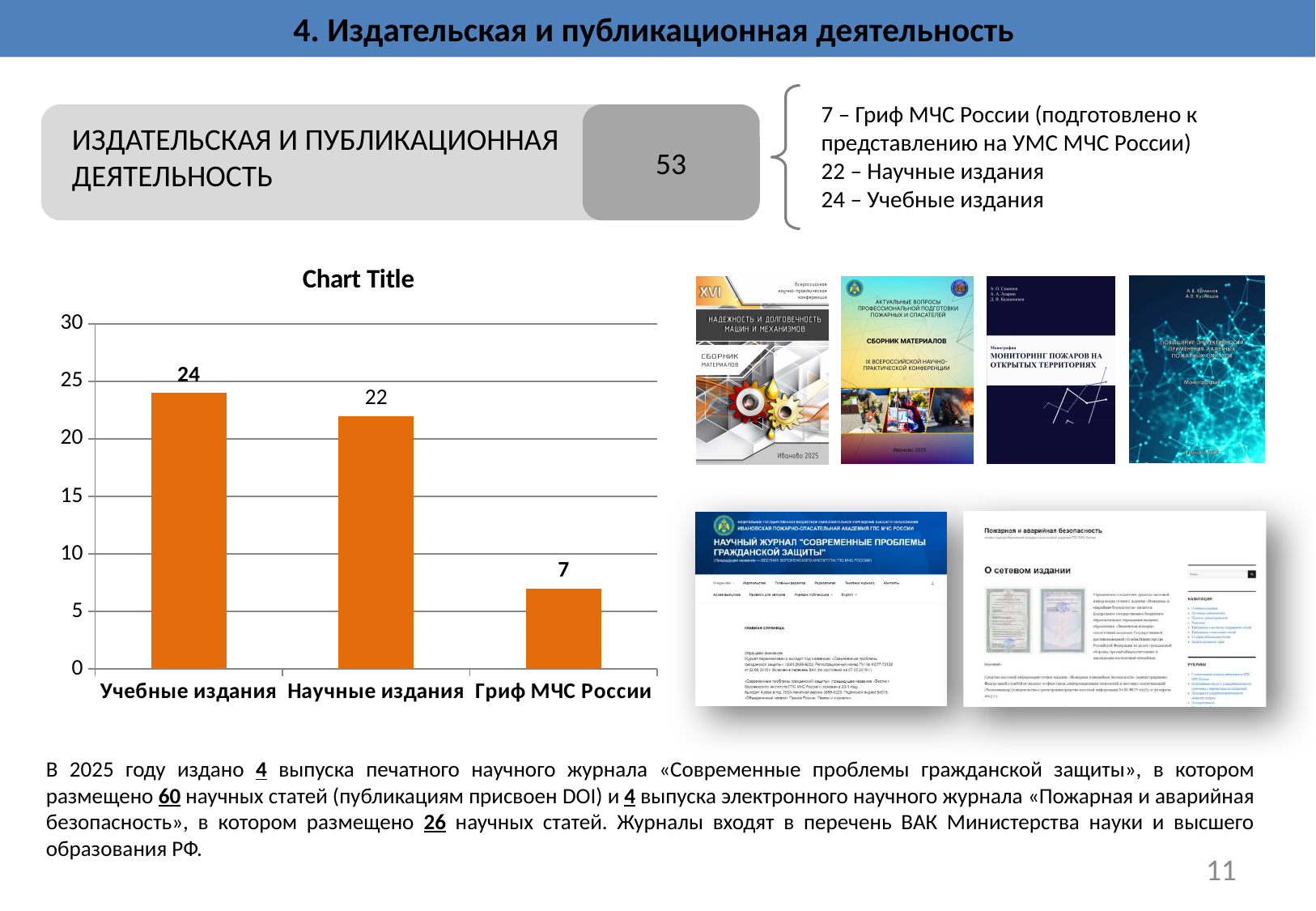
Which category has the lowest value? Гриф МЧС России What kind of chart is shown on the slide? bar chart How many categories are shown in the chart? 3 What is the value for Научные издания? 22 Is the value for Гриф МЧС России greater or less than 10? less What is the title of the chart? Chart Title What is the value for Гриф МЧС России? 7 What is the difference between the values for Учебные издания and Научные издания? 2 What is the difference between the values for Учебные издания and Гриф МЧС России? 17 Which is larger, the value for Научные издания or the value for Гриф МЧС России? Научные издания Which category has the highest value? Учебные издания What is the value for Учебные издания? 24